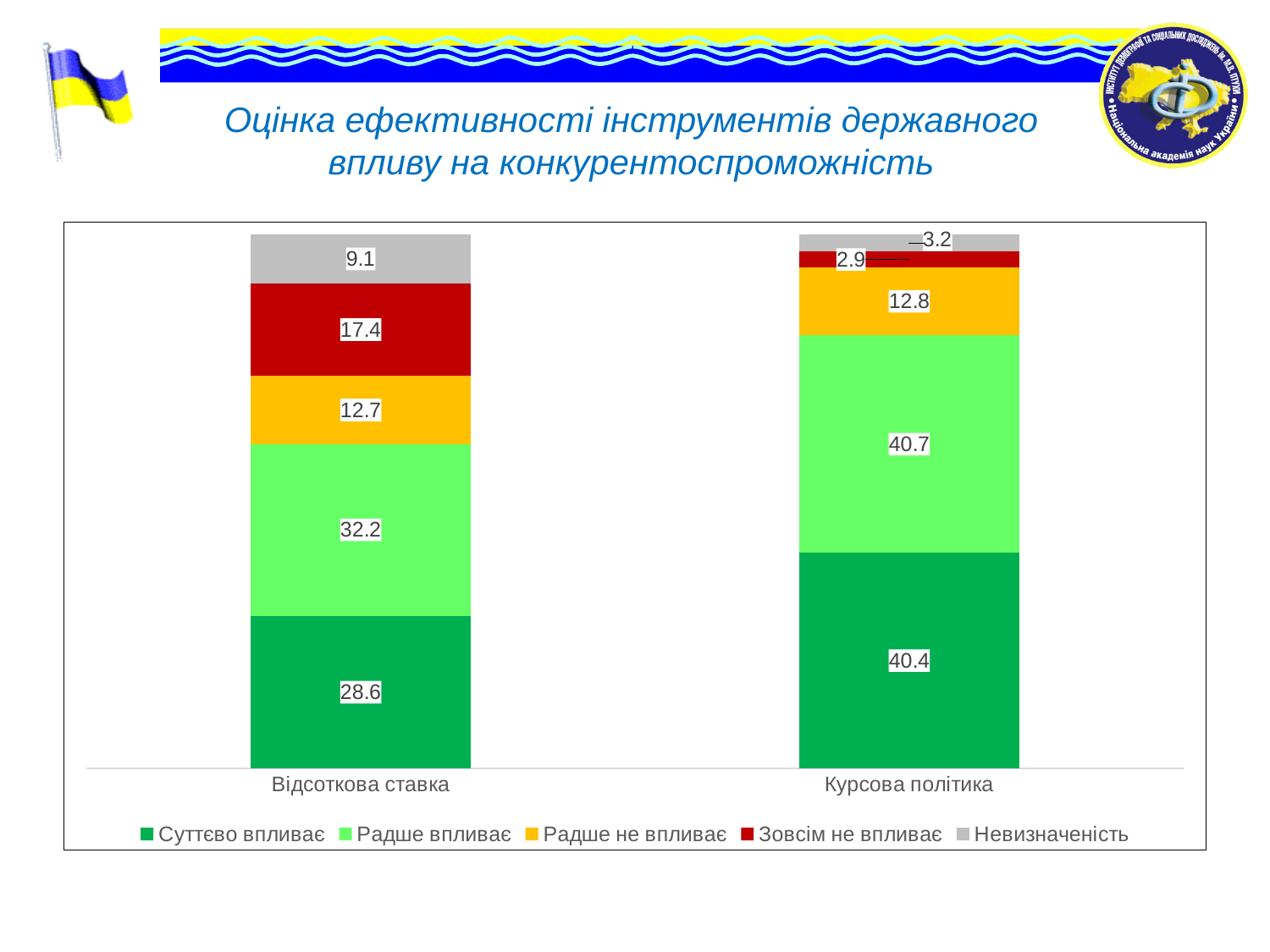
What is the difference between the "Суттєво впливає" values for "Курсова політика" and "Відсоткова ставка"? 11.8 What is the value of "Суттєво впливає" for "Відсоткова ставка"? 28.6 Which category has the higher value for "Зовсім не впливає": "Відсоткова ставка" or "Курсова політика"? Відсоткова ставка What is the total of the stacked bar for "Відсоткова ставка"? 100.0 Which series has the smallest segment in the "Курсова політика" bar? Зовсім не впливає What type of chart is shown on the slide? stacked bar chart What is the value of "Невизначеність" for "Відсоткова ставка"? 9.1 What is the value of "Зовсім не впливає" for "Курсова політика"? 2.9 How many series does the chart legend list? 5 How many categories are shown on the x axis of the chart? 2 Which series has the largest segment in the "Відсоткова ставка" bar? Радше впливає What is the value of "Радше впливає" for "Курсова політика"? 40.7